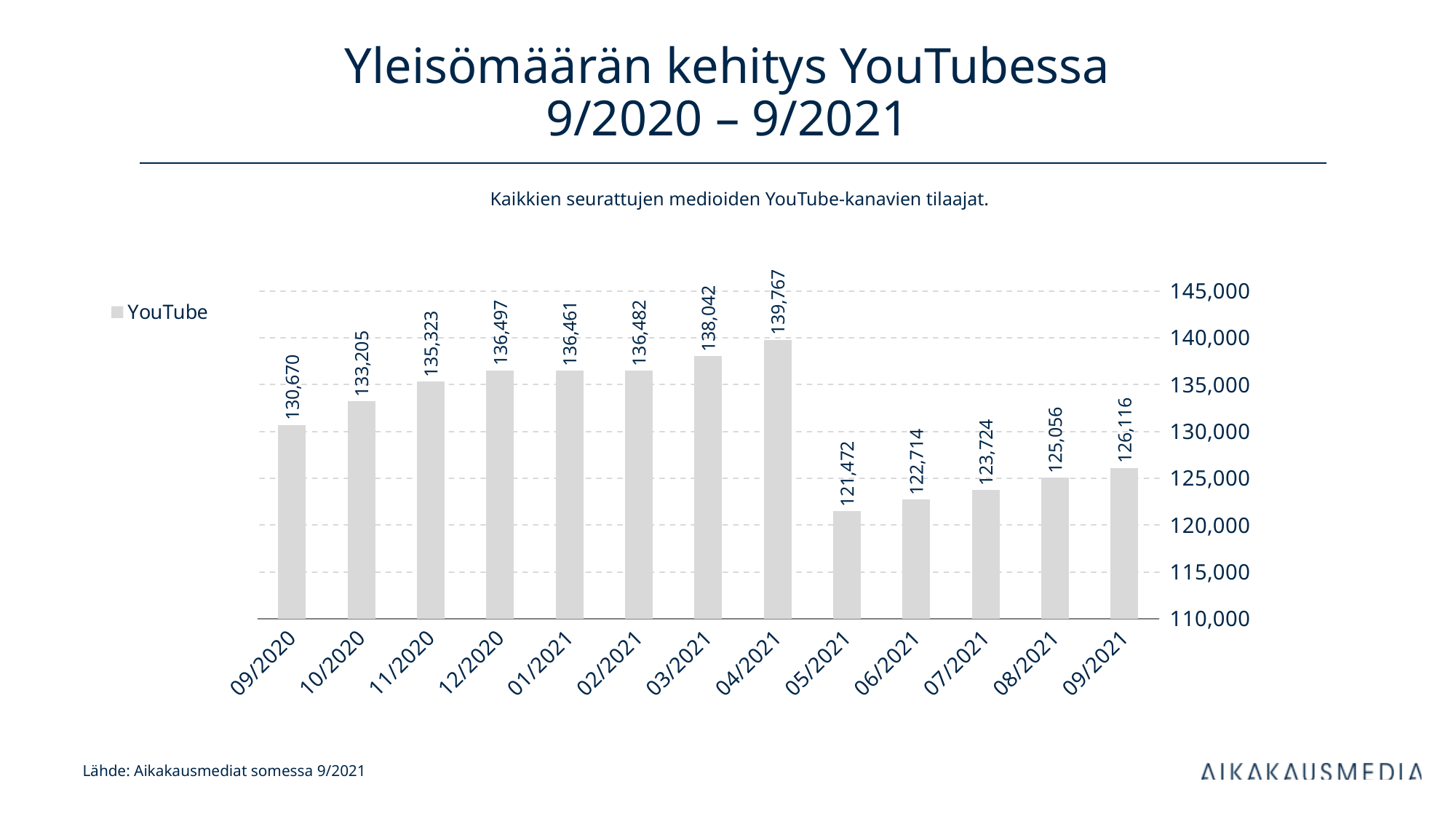
What is the value for 09/2020? 130,670 Which month has the highest value? 04/2021 Which is larger, the value for 09/2020 or the value for 09/2021? 09/2020 What is the difference between the values for 04/2021 and 05/2021? 18,295 Is the value for 03/2021 greater or less than 135,000? greater How many series does the legend list? 1 What is the value for 05/2021? 121,472 How many months are shown on the x axis? 13 Which month has the lowest value? 05/2021 What kind of chart is shown? bar chart What is the value for 04/2021? 139,767 What is the title of the chart? Yleisömäärän kehitys YouTubessa 9/2020 – 9/2021